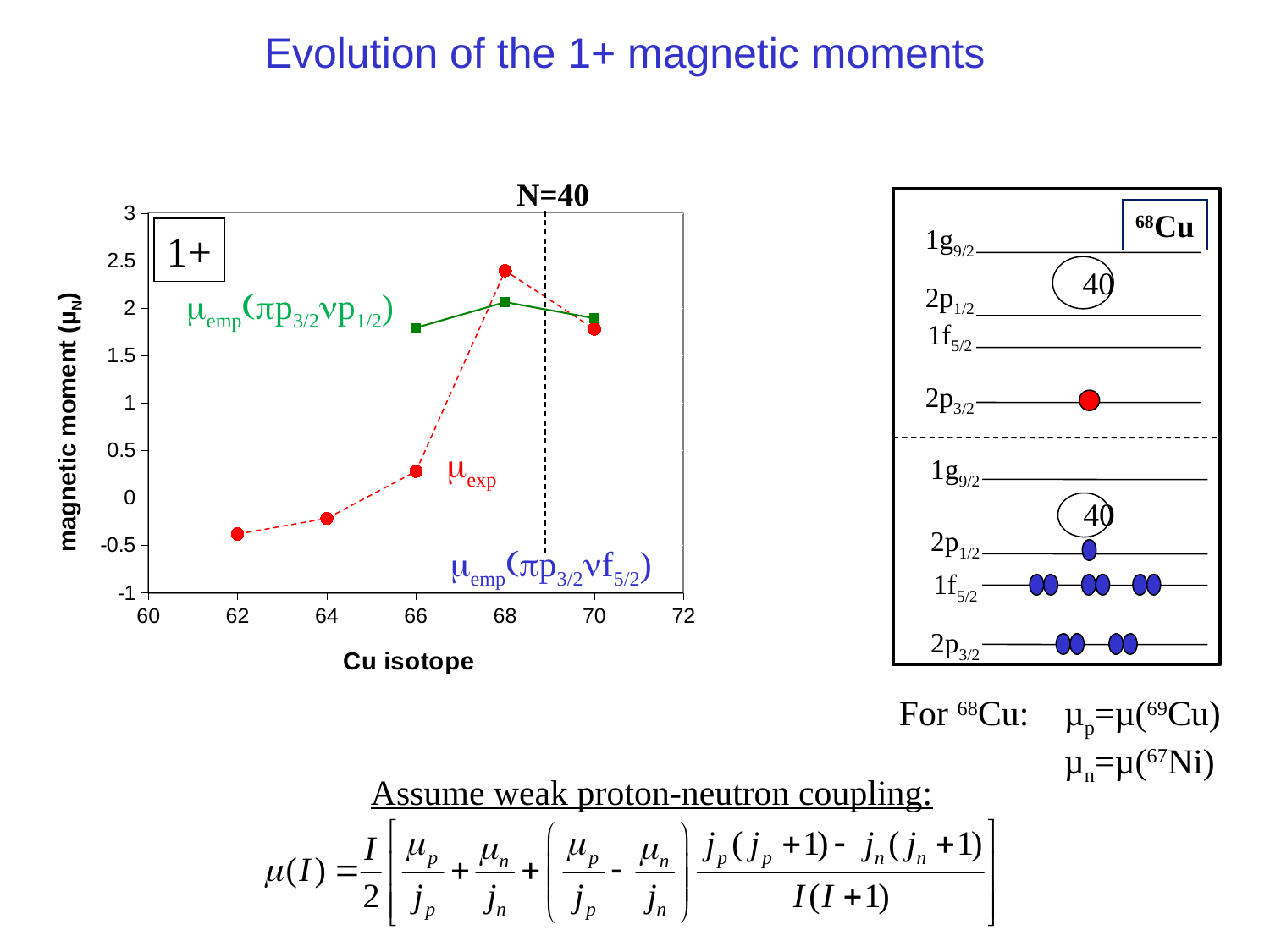
At which Cu isotope does the μ_exp series have its lowest value? 62 Is the green μ_emp(πp3/2 νp1/2) value for Cu isotope 66 greater or less than 1.5? greater Is the μ_exp value for Cu isotope 62 greater or less than 0? less How many data points does the green μ_emp(πp3/2 νp1/2) series have? 3 Is the μ_exp value for Cu isotope 66 greater or less than 0.5? less At which Cu isotope does the μ_exp series reach its highest value? 68 At Cu isotope 68, which is larger: the μ_exp value or the green μ_emp(πp3/2 νp1/2) value? μ_exp What kind of chart is shown on the left of the slide? line chart How many data points does the red dashed μ_exp series have? 5 Does the μ_exp series rise or fall from Cu isotope 62 to 68? rise What label is written above the dashed vertical line in the chart? N=40